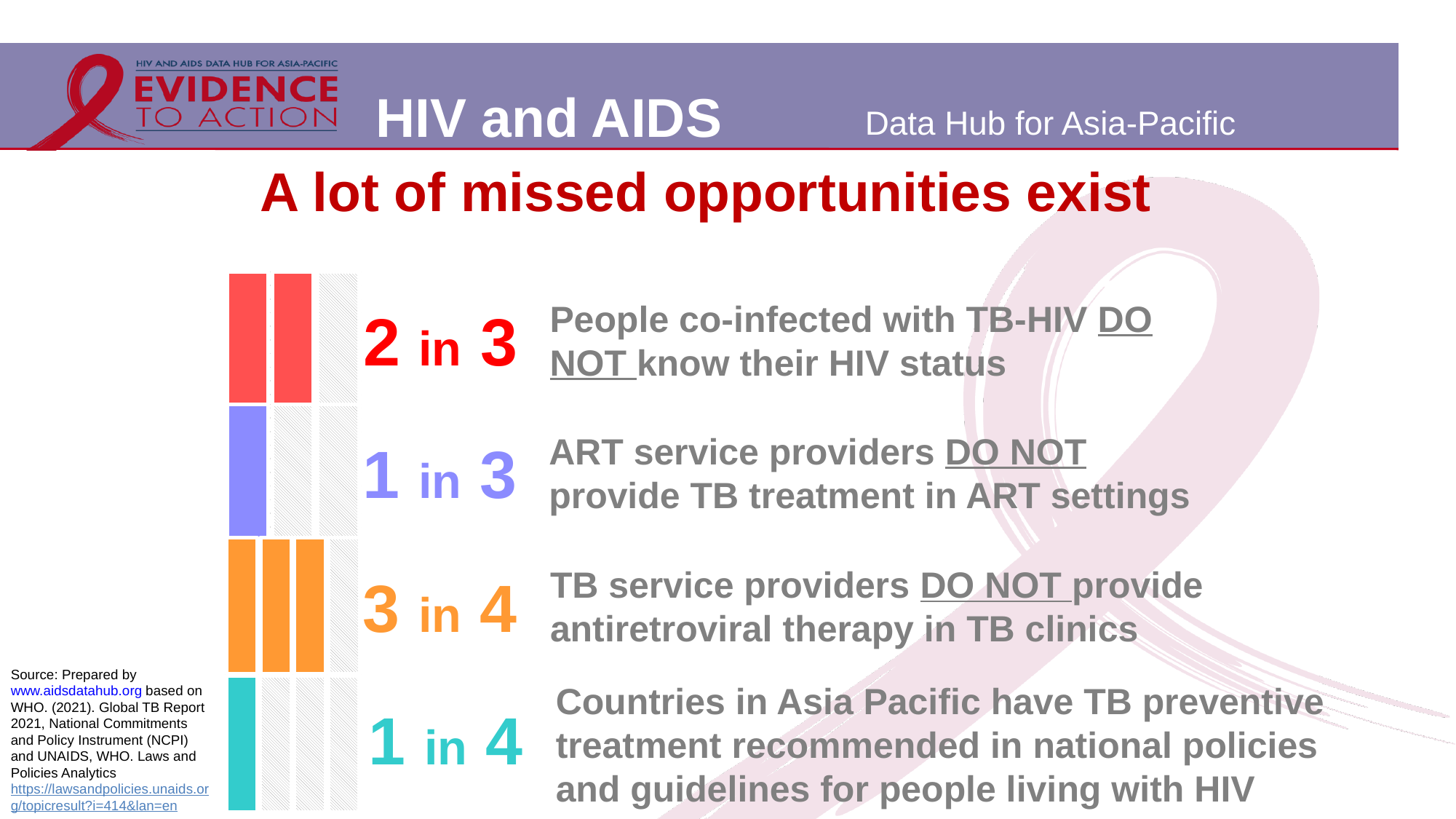
What proportion of TB service providers do not provide antiretroviral therapy in TB clinics? 3 in 4 What proportion of people co-infected with TB-HIV do not know their HIV status? 2 in 3 What colour are the filled bars for the '3 in 4' statistic? Orange How many bar segments are filled in the row for people co-infected with TB-HIV who do not know their HIV status? 2 How many 'X in Y' statistics are shown on the slide? 4 What proportion of countries in Asia Pacific have TB preventive treatment recommended in national policies and guidelines for people living with HIV? 1 in 4 Which statistic on the slide represents the largest proportion? 3 in 4 (TB service providers do not provide antiretroviral therapy in TB clinics) How many bar segments in total are shown in the row for TB service providers who do not provide antiretroviral therapy in TB clinics? 4 Which is larger: the proportion of people co-infected with TB-HIV who do not know their HIV status, or the proportion of ART service providers who do not provide TB treatment in ART settings? People co-infected with TB-HIV who do not know their HIV status (2 in 3) What is the title of the slide? A lot of missed opportunities exist Which statistic on the slide represents the smallest proportion? 1 in 4 (countries with TB preventive treatment recommended in national policies) What proportion of ART service providers do not provide TB treatment in ART settings? 1 in 3